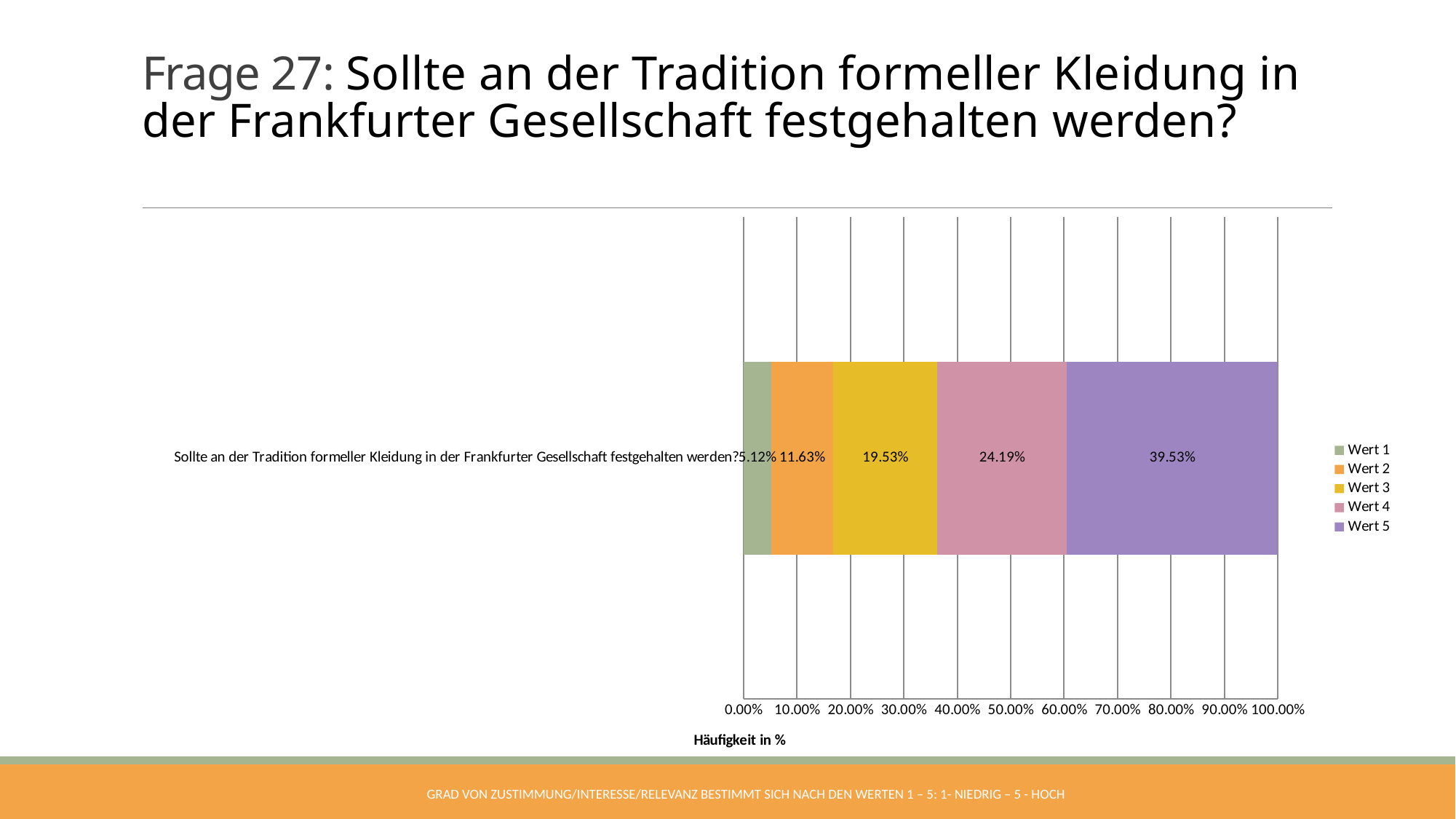
What is the value for Wert 4? 24.19% What is the total of the stacked bar? 100.00% How many series does the legend list? 5 What is the value for Wert 1? 5.12% Which series has the lowest value? Wert 1 What is the title of the horizontal axis? Häufigkeit in % What is the difference between the values for Wert 5 and Wert 4? 15.34% What kind of chart is shown on the slide? Stacked bar chart Which series has the highest value? Wert 5 Which is larger, the value for Wert 2 or the value for Wert 3? Wert 3 What is the value for Wert 5? 39.53% What is the value for Wert 3? 19.53%